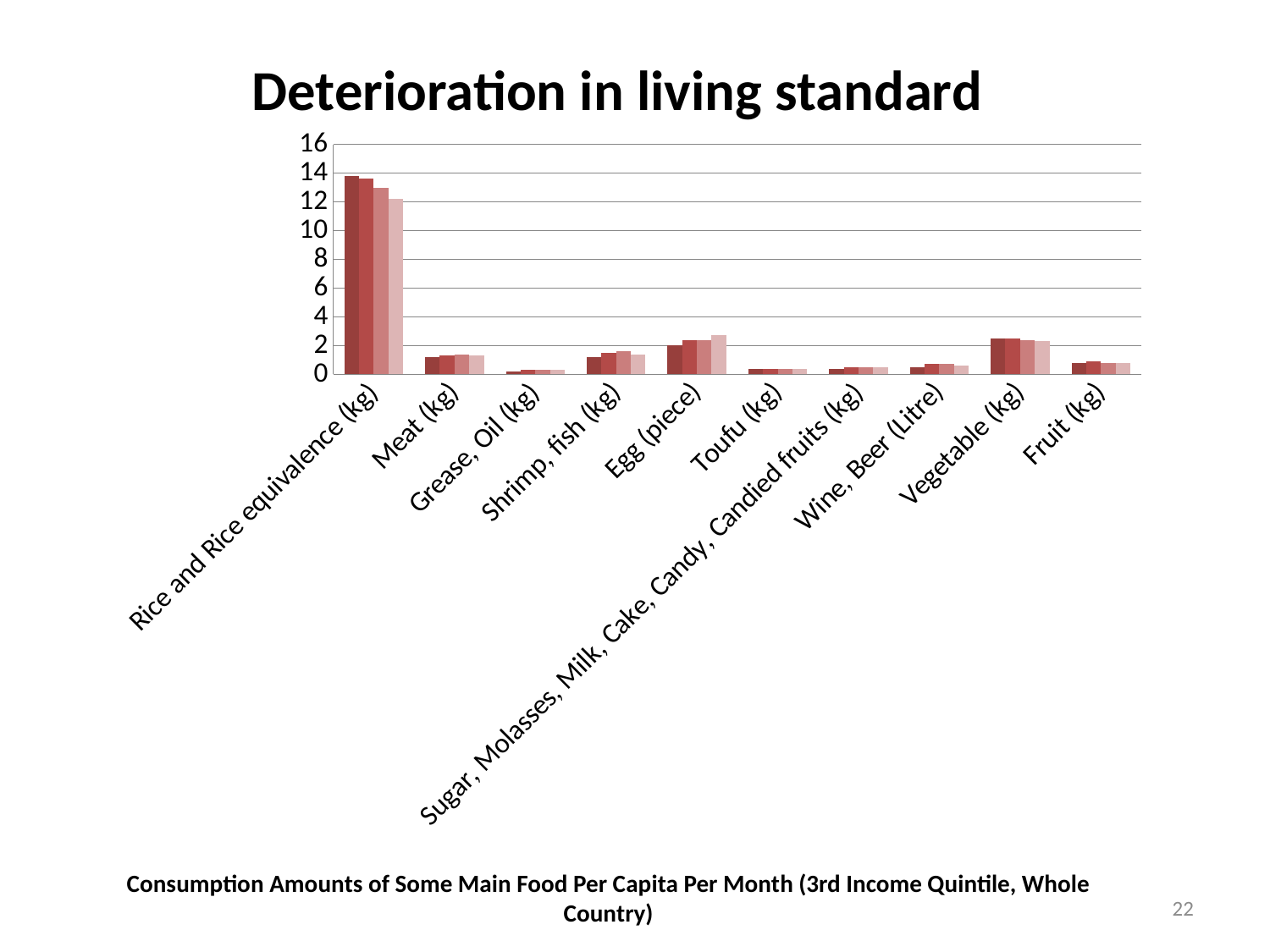
What kind of chart is shown on the slide? bar chart Do the four bars for Rice and Rice equivalence (kg) rise or fall from left to right? fall How many food categories are shown along the x axis? 10 Which food category has the lowest consumption amounts? Grease, Oil (kg) Is the tallest bar for Rice and Rice equivalence (kg) greater or less than 12? greater Which has higher values, Vegetable (kg) or Fruit (kg)? Vegetable (kg) Which has higher values, Egg (piece) or Toufu (kg)? Egg (piece) How many bars are plotted for each food category? 4 What is the caption below the chart? Consumption Amounts of Some Main Food Per Capita Per Month (3rd Income Quintile, Whole Country) Are the bars for Vegetable (kg) greater or less than 4? less Which food category has the highest consumption amounts? Rice and Rice equivalence (kg) Are the bars for Meat (kg) greater or less than 2? less